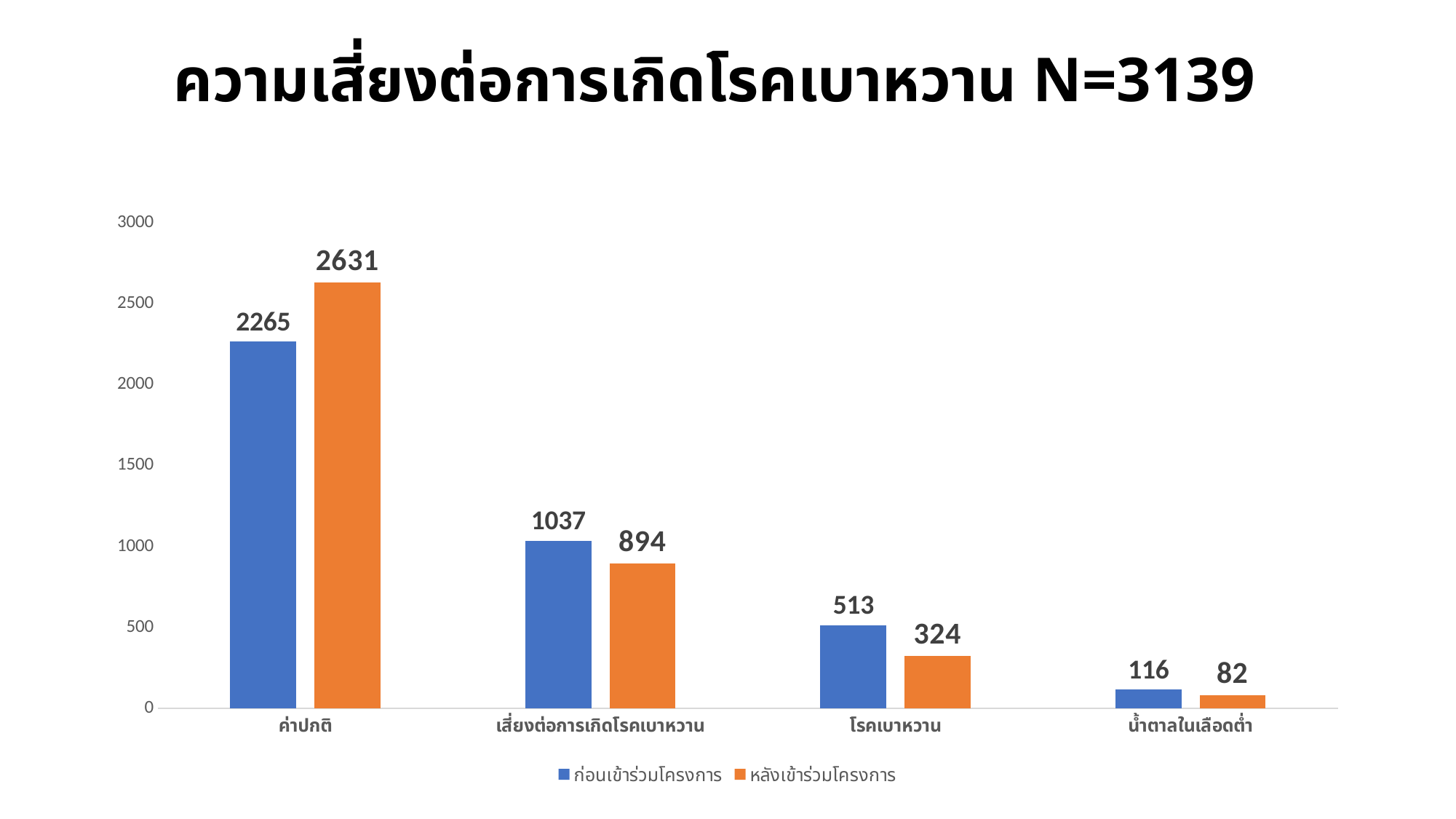
What is the value for น้ำตาลในเลือดต่ำ in the ก่อนเข้าร่วมโครงการ series? 116 What is the value for โรคเบาหวาน in the หลังเข้าร่วมโครงการ series? 324 What kind of chart is shown on the slide? Bar chart What is the difference between the ก่อนเข้าร่วมโครงการ and หลังเข้าร่วมโครงการ values for เสี่ยงต่อการเกิดโรคเบาหวาน? 143 How many categories are shown on the x axis? 4 What is the difference between the หลังเข้าร่วมโครงการ and ก่อนเข้าร่วมโครงการ values for ค่าปกติ? 366 For โรคเบาหวาน, which series has the larger value, ก่อนเข้าร่วมโครงการ or หลังเข้าร่วมโครงการ? ก่อนเข้าร่วมโครงการ What is the title of the chart? ความเสี่ยงต่อการเกิดโรคเบาหวาน N=3139 Which category has the highest value in the หลังเข้าร่วมโครงการ series? ค่าปกติ Which category has the lowest value in the ก่อนเข้าร่วมโครงการ series? น้ำตาลในเลือดต่ำ What is the value for ค่าปกติ in the ก่อนเข้าร่วมโครงการ series? 2265 How many series does the legend list? 2